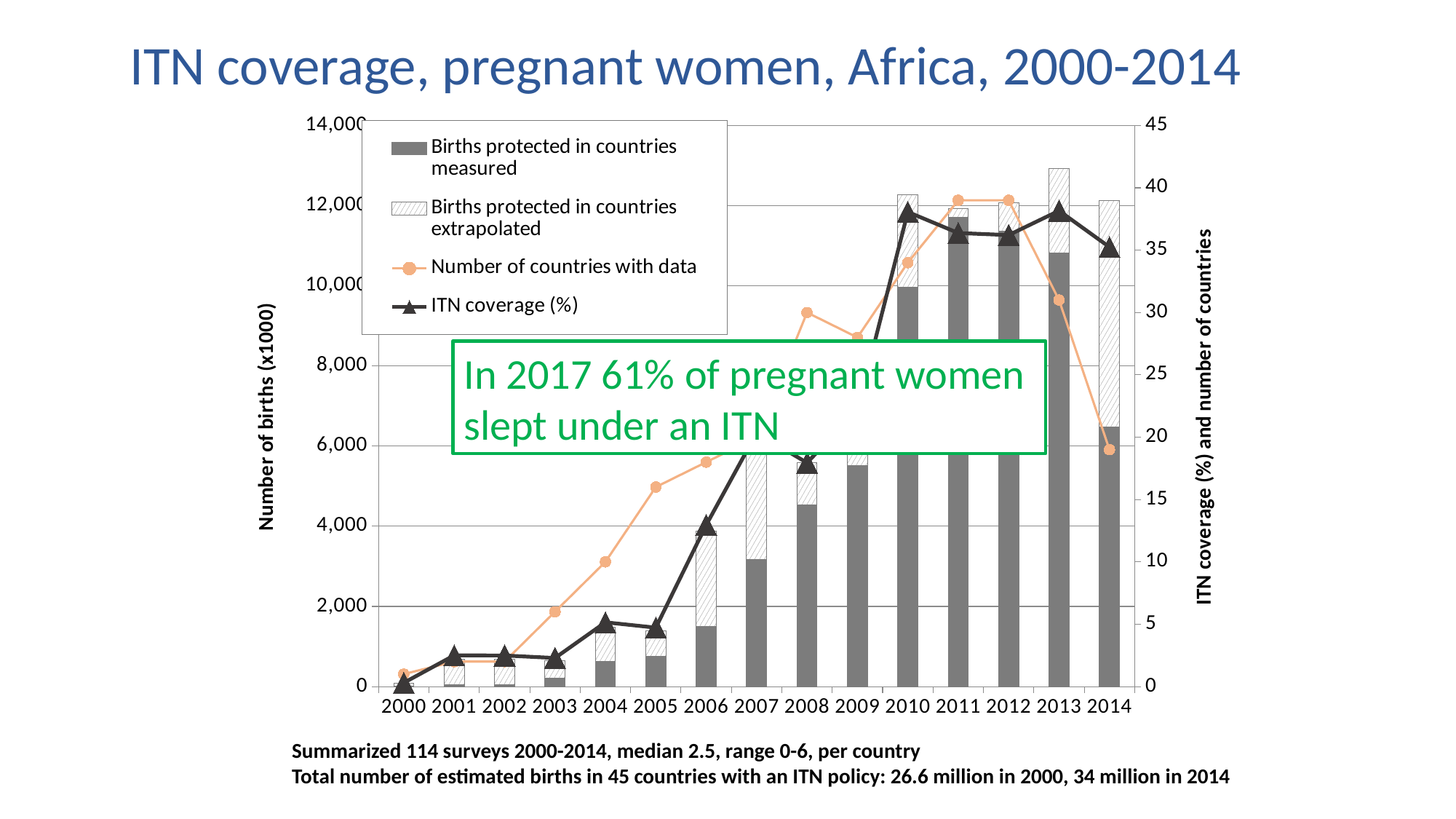
Is the value for births protected in countries measured in 2013 greater or less than 10,000? greater Which year has the higher ITN coverage (%), 2006 or 2007? 2007 Is the ITN coverage (%) value for 2006 greater or less than 10? greater How many years are shown along the x axis of the chart? 15 What kind of chart is shown on the slide? A combination chart of stacked bars and lines How does ITN coverage (%) change from 2000 to 2010? It rises Which year has the tallest total bar (births protected, measured plus extrapolated)? 2013 What is the title of the chart? ITN coverage, pregnant women, Africa, 2000-2014 How many series does the chart's legend list? 4 Is the number of countries with data in 2014 greater or less than 25? less What is the label of the right-hand vertical axis? ITN coverage (%) and number of countries In which year is the number of countries with data lowest? 2000